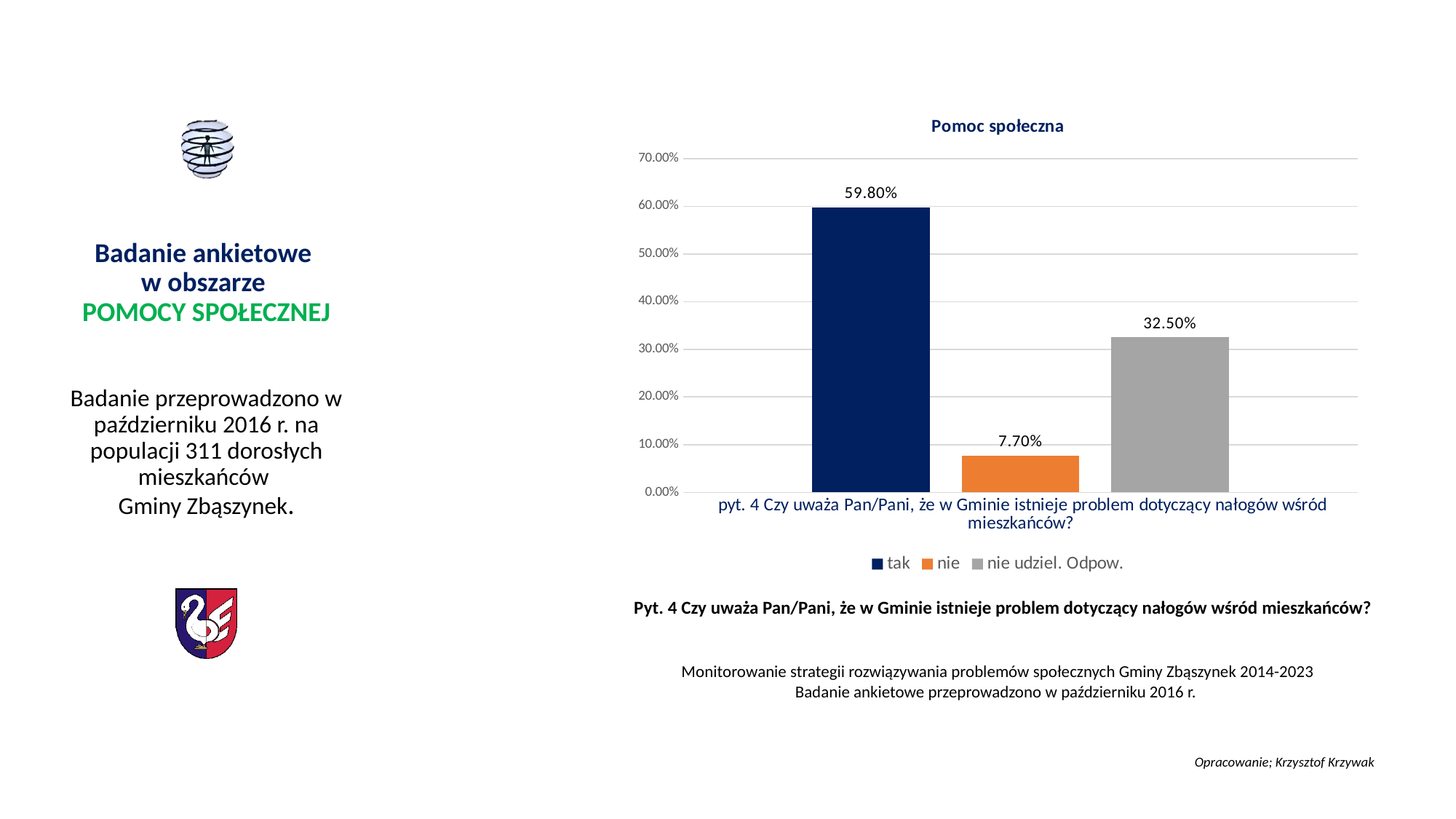
What is the value for "nie"? 7.70% Which series has the lowest value? nie What is the value for "tak"? 59.80% Which series has the highest value? tak What kind of chart is shown on the slide? bar chart Is the value for "tak" greater or less than 50.00%? greater What is the difference between the values for "nie udziel. Odpow." and "nie"? 24.80% Which is larger, the value for "nie" or the value for "nie udziel. Odpow."? nie udziel. Odpow. What is the title of the chart? Pomoc społeczna What is the difference between the values for "tak" and "nie"? 52.10% How many series does the legend list? 3 What is the value for "nie udziel. Odpow."? 32.50%